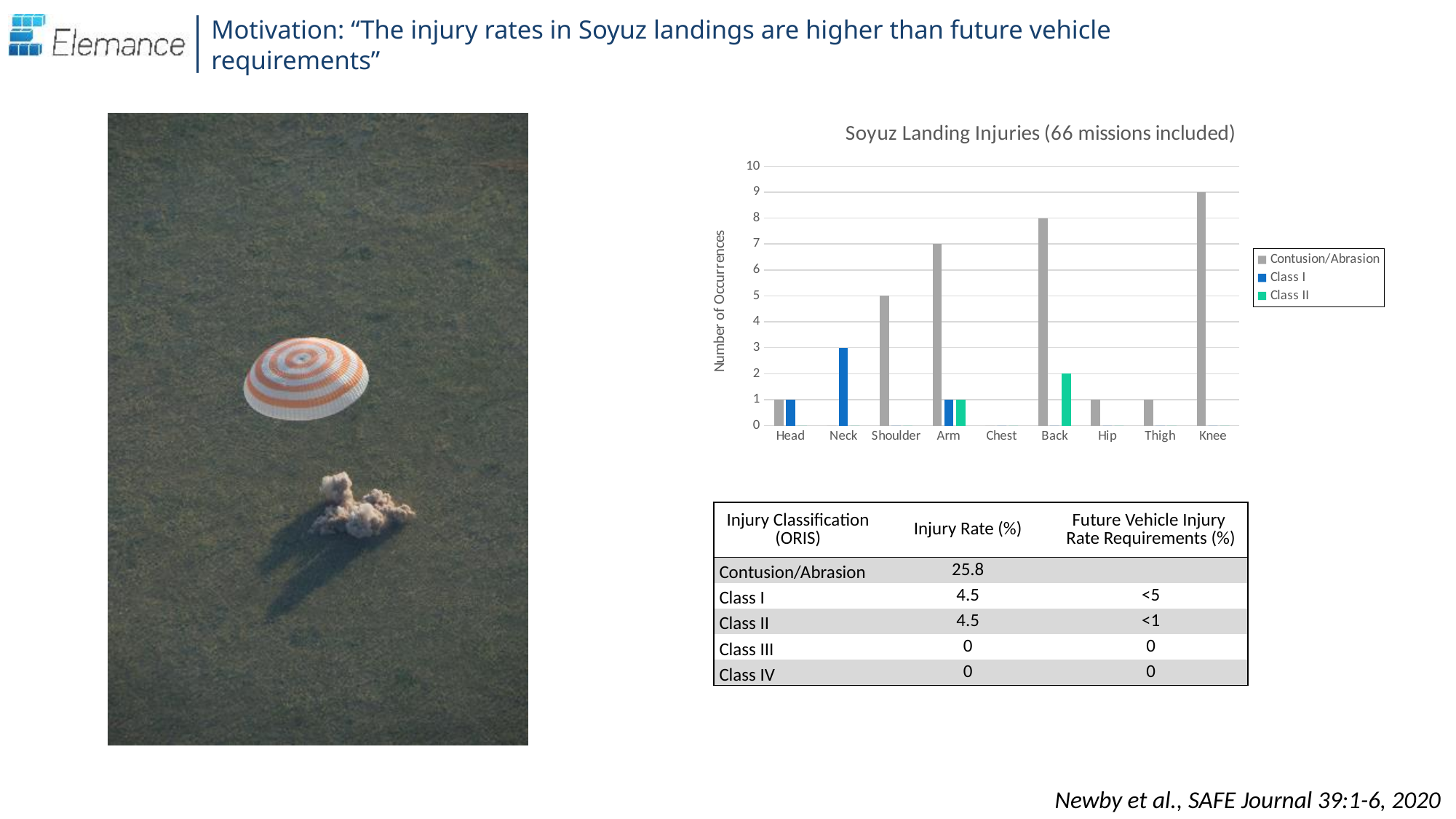
What is the label of the y axis of the chart? Number of Occurrences Which category has the highest number of Contusion/Abrasion occurrences? Knee What is the title of the chart? Soyuz Landing Injuries (66 missions included) How many Contusion/Abrasion occurrences are shown for Shoulder? 5 How many series does the chart legend list? 3 What kind of chart is shown on the slide? bar chart Which has more Contusion/Abrasion occurrences, Knee or Shoulder? Knee How many body-region categories are shown on the x axis of the chart? 9 How many Contusion/Abrasion occurrences are shown for Knee? 9 How many Class I occurrences are shown for Neck? 3 What is the difference between the Contusion/Abrasion occurrences for Back and for Arm? 1 How many Class II occurrences are shown for Back? 2